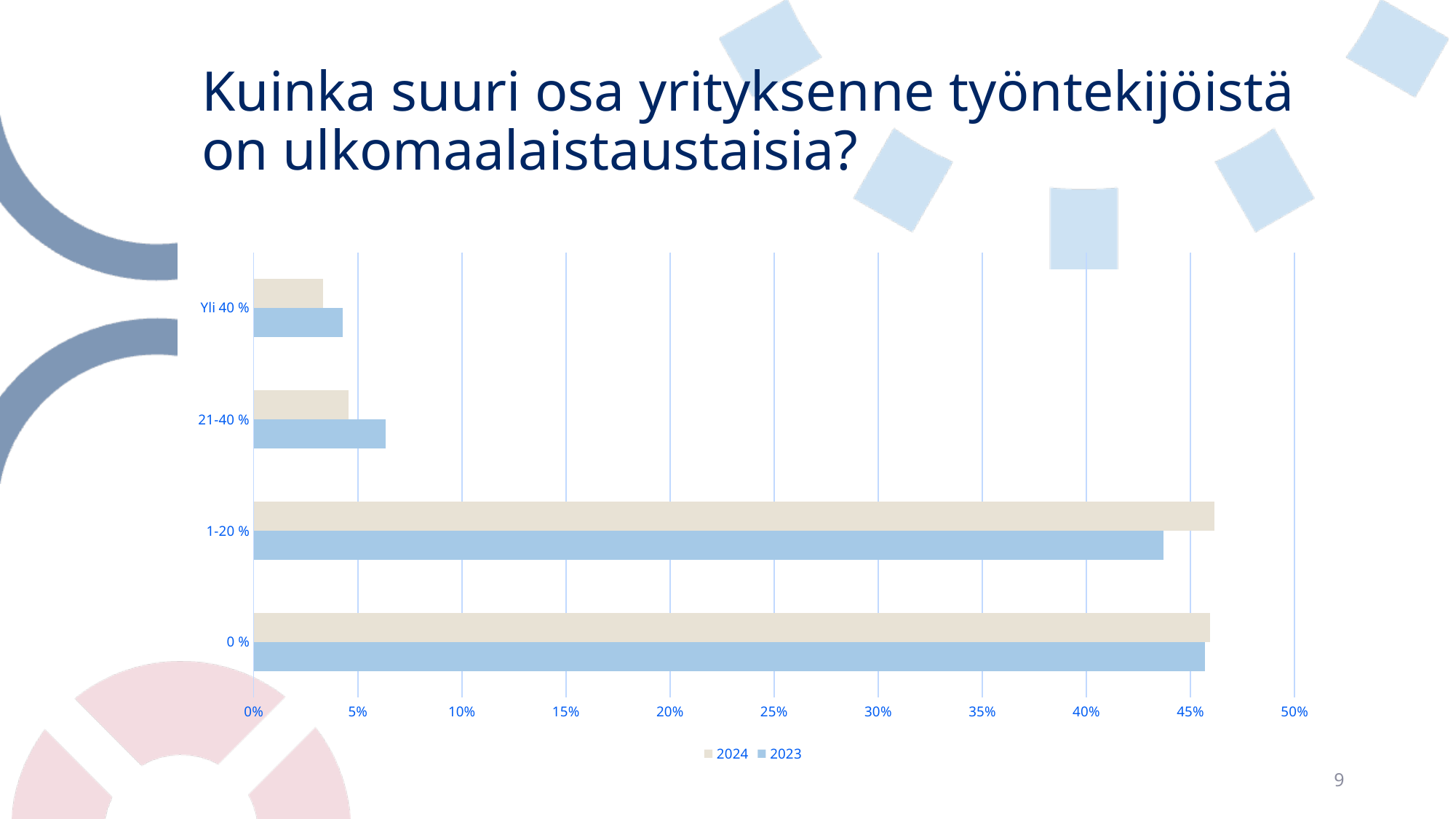
Which series are listed in the legend? 2024 and 2023 What kind of chart is shown on the slide? bar chart Which category has the highest value for the 2023 series? 0 % For the category 21-40 %, which series has the larger value, 2024 or 2023? 2023 How many series does the legend list? 2 Is the 2023 value for 1-20 % greater or less than 45%? less For the category 1-20 %, which series has the larger value, 2024 or 2023? 2024 How many categories are shown on the chart? 4 Which category has the lowest value for the 2024 series? Yli 40 % Is the 2024 value for 0 % greater or less than 40%? greater Is the 2023 value for 21-40 % greater or less than 5%? greater Which category has the lowest value for the 2023 series? Yli 40 %